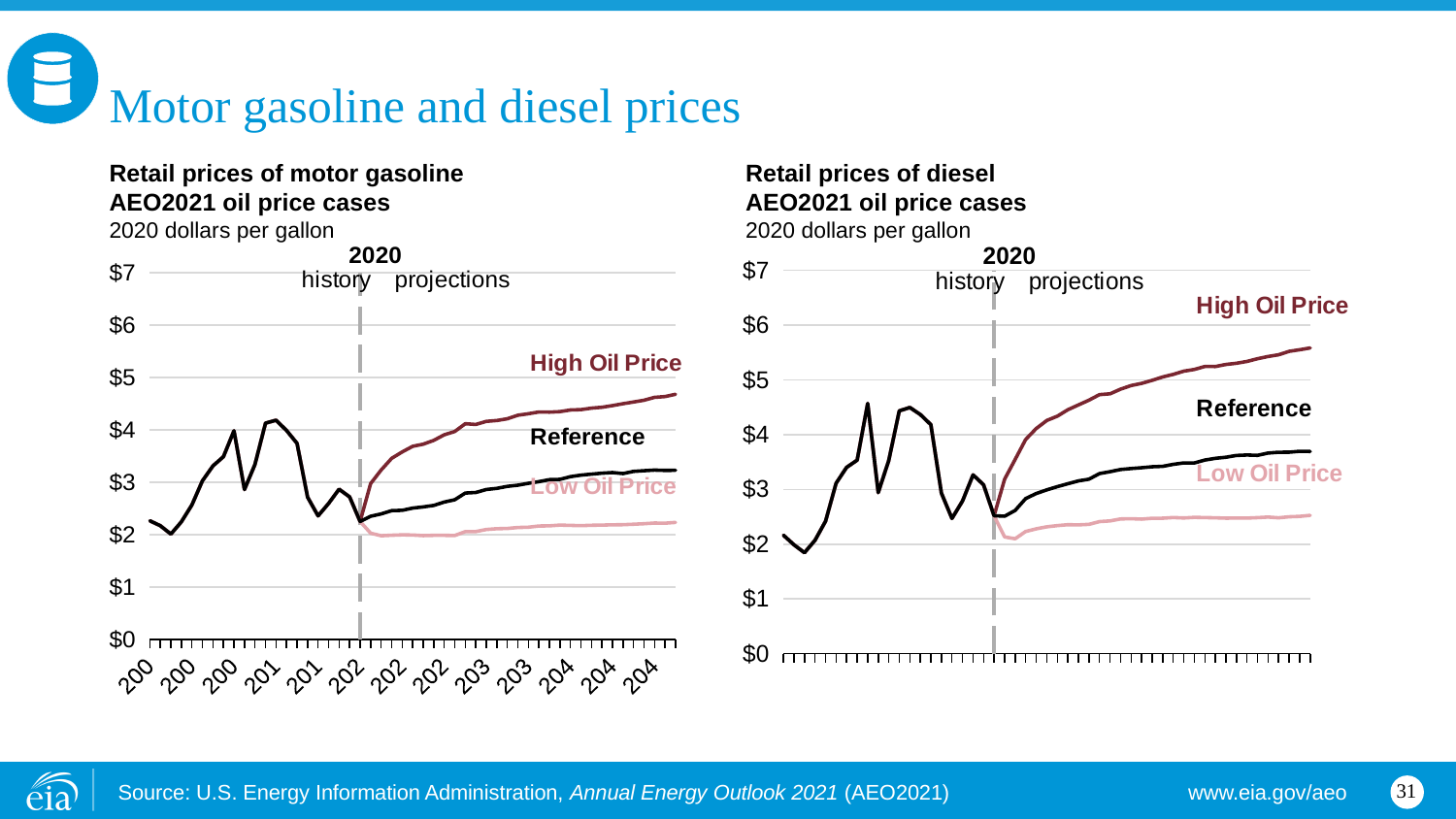
What kind of chart is the 'Retail prices of motor gasoline' chart? line chart What unit is used on the y axis of both charts? 2020 dollars per gallon What year separates history from projections on the charts? 2020 On the 'Retail prices of motor gasoline' chart, is the High Oil Price value at the end of the projection period greater or less than $4? greater On the 'Retail prices of motor gasoline' chart, which series is highest at the end of the projection period? High Oil Price On the 'Retail prices of motor gasoline' chart, is the Low Oil Price value at the end of the projection period greater or less than $3? less On the 'Retail prices of diesel' chart, is the High Oil Price value at the end of the projection period greater or less than $5? greater On the 'Retail prices of diesel' chart, which series is lowest at the end of the projection period? Low Oil Price On the 'Retail prices of diesel' chart, which is larger at the end of the projection period, the High Oil Price case or the Reference case? High Oil Price How many price cases (series) are plotted on the 'Retail prices of diesel' chart? 3 On the 'Retail prices of motor gasoline' chart, does the High Oil Price series rise or fall over the projection period? rise